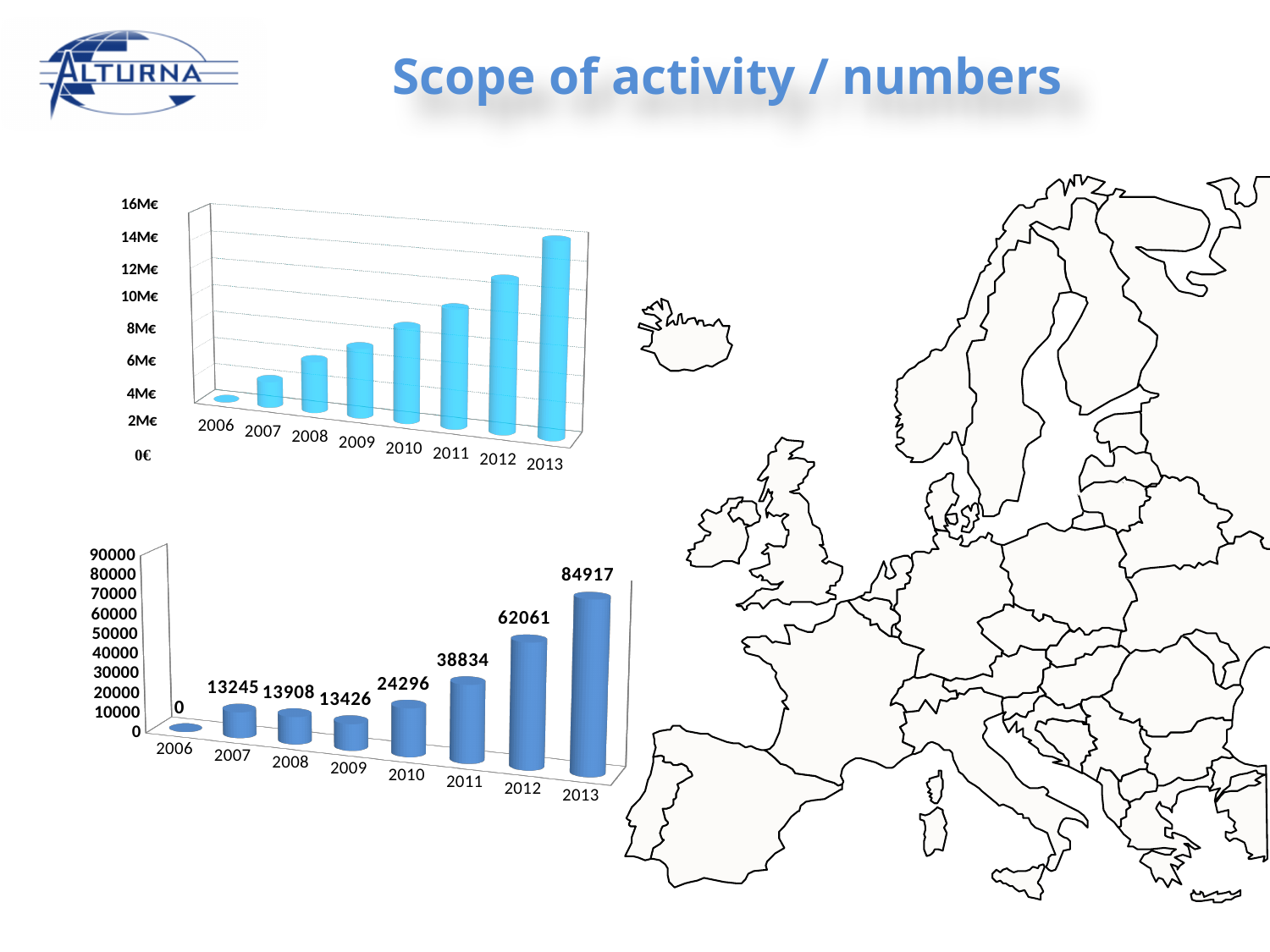
What kind of chart is the top chart? bar chart In the bottom chart, which is larger, the value for 2008 or the value for 2009? 2008 In the top chart, do the values generally rise or fall from 2006 to 2013? rise In the bottom chart, which year has the lowest value? 2006 In the bottom chart, what is the value for 2011? 38834 How many years are shown in the bottom chart? 8 In the bottom chart, what is the difference between the values for 2011 and 2010? 14538 In the bottom chart, which year has the highest value? 2013 In the bottom chart, what is the value for 2013? 84917 In the top chart, is the value for 2013 greater or less than 8M€? greater In the bottom chart, what is the difference between the values for 2013 and 2012? 22856 In the bottom chart, what is the value for 2006? 0